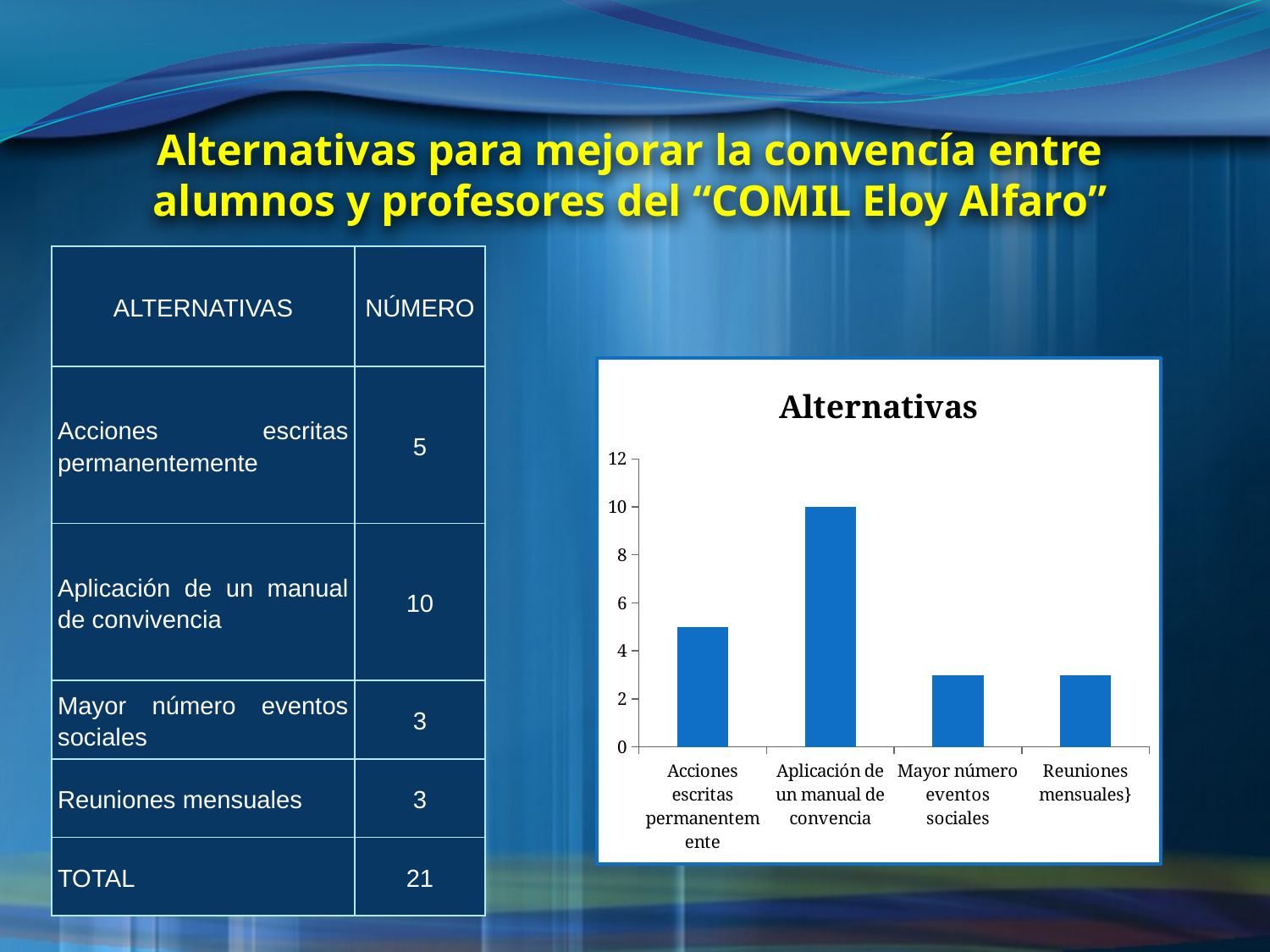
What is the difference between the value for "Aplicación de un manual de convencia" and the value for "Acciones escritas permanentemente"? 5 What kind of chart is shown on the slide? bar chart What is the value for "Aplicación de un manual de convencia" in the chart? 10 What is the value for "Acciones escritas permanentemente" in the chart? 5 Which is larger, the value for "Acciones escritas permanentemente" or the value for "Mayor número eventos sociales"? Acciones escritas permanentemente How many categories are plotted in the chart? 4 What is the value for "Mayor número eventos sociales" in the chart? 3 Is the value for "Reuniones mensuales" greater or less than 4? less What is the title of the chart? Alternativas What is the highest value shown on the vertical axis of the chart? 12 Is the value for "Acciones escritas permanentemente" greater or less than 4? greater Which category has the highest bar in the chart? Aplicación de un manual de convencia